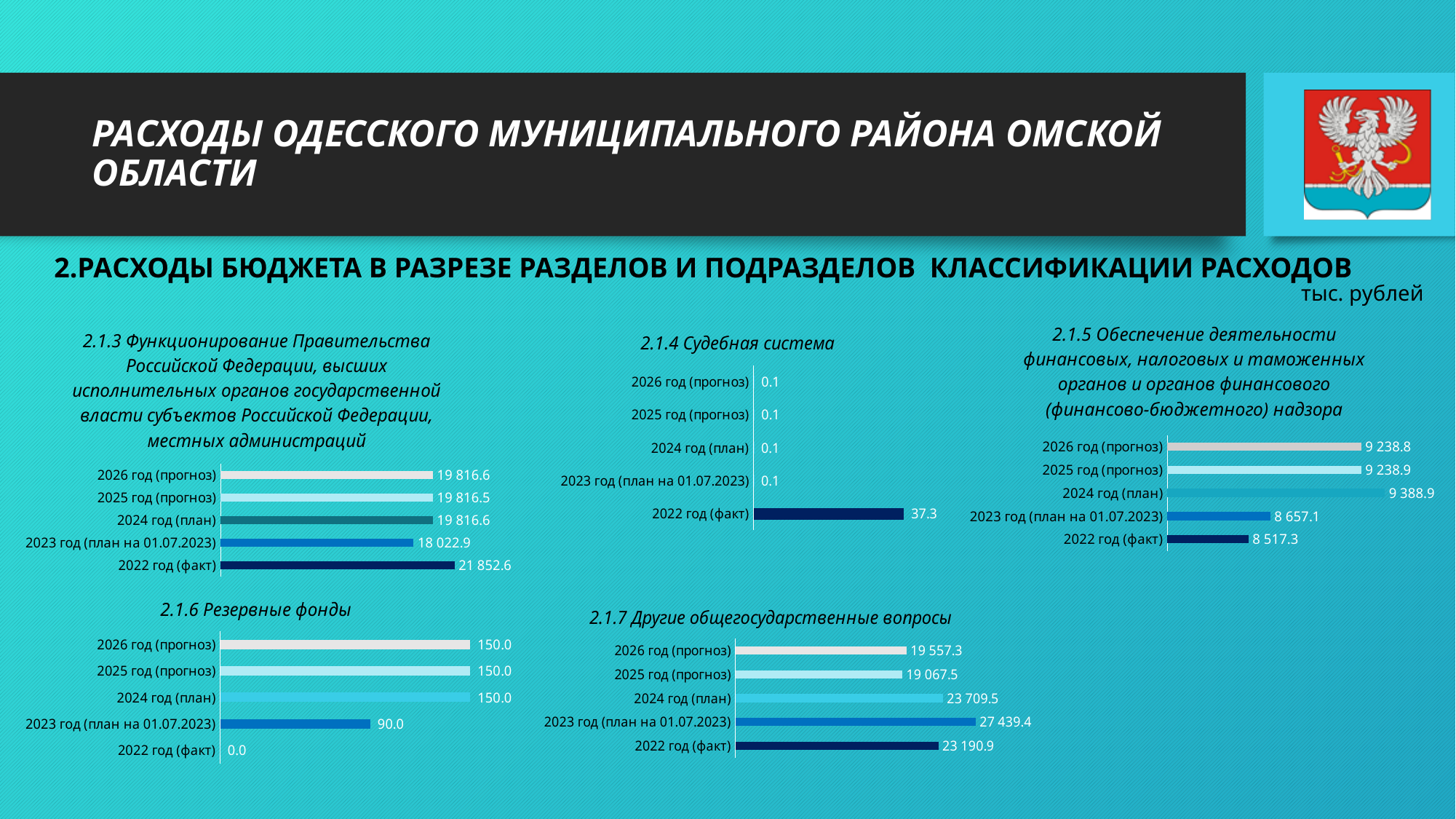
In the chart '2.1.6 Резервные фонды', which category has the lowest value? 2022 год (факт) In the chart '2.1.5 Обеспечение деятельности финансовых, налоговых и таможенных органов...', which category has the highest value? 2024 год (план) In the chart '2.1.3 Функционирование Правительства Российской Федерации...', which category has the lowest value? 2023 год (план на 01.07.2023) In the chart '2.1.6 Резервные фонды', what is the value for 2023 год (план на 01.07.2023)? 90.0 How many categories does the chart '2.1.7 Другие общегосударственные вопросы' show? 5 In the chart '2.1.4 Судебная система', what is the value for 2022 год (факт)? 37.3 In the chart '2.1.5 Обеспечение деятельности финансовых, налоговых и таможенных органов...', what is the difference between 2023 год (план на 01.07.2023) and 2022 год (факт)? 139.8 In the chart '2.1.7 Другие общегосударственные вопросы', which category has the highest value? 2023 год (план на 01.07.2023) In the chart '2.1.3 Функционирование Правительства Российской Федерации...', what is the value for 2022 год (факт)? 21 852.6 In the chart '2.1.4 Судебная система', what is the value for 2024 год (план)? 0.1 In the chart '2.1.7 Другие общегосударственные вопросы', which is larger: 2024 год (план) or 2022 год (факт)? 2024 год (план) What type of chart is '2.1.6 Резервные фонды'? Bar chart